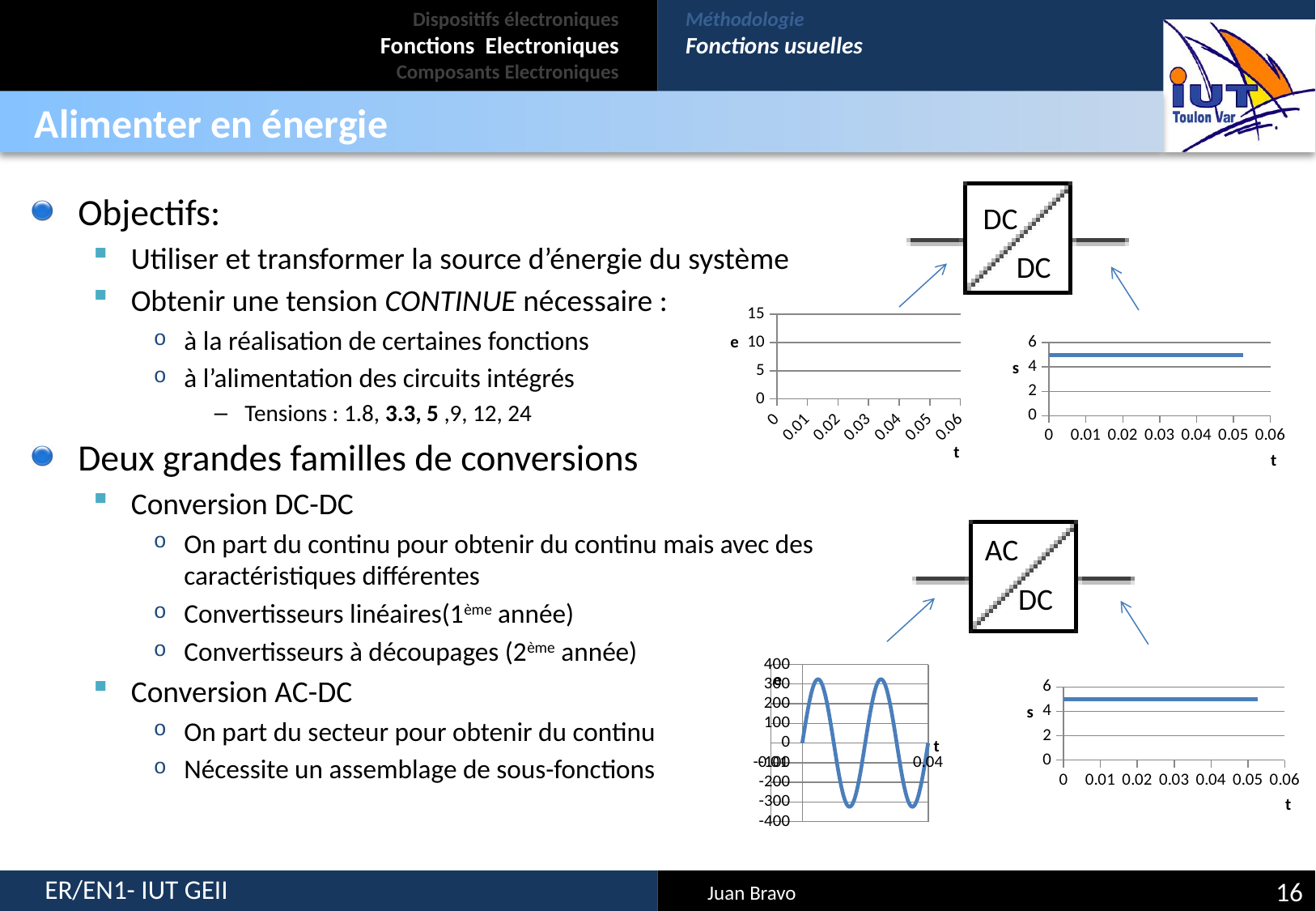
In the top-right chart labelled 's' (below the DC/DC block), does the line rise, fall or stay flat along the t axis? stays flat In the bottom-right chart labelled 's' (below the AC/DC block), does the line rise, fall or stay flat along the t axis? stays flat What type of chart is the top-left chart labelled 'e' (below the DC/DC block)? line chart In the top-left chart labelled 'e', what is the highest value shown on the y axis? 15 What type of chart is the bottom-left chart labelled 'e' (below the AC/DC block)? line chart How many charts are shown on the slide? 4 In the bottom-right chart labelled 's' (below the AC/DC block), is the value of the line greater or less than 2? greater In the bottom-left chart labelled 'e' (below the AC/DC block), what is the lowest value shown on the y axis? -400 In the top-right chart labelled 's' (below the DC/DC block), is the value of the line greater or less than 6? less In the bottom-left chart labelled 'e' (below the AC/DC block), is the peak value of the wave greater or less than 300? greater